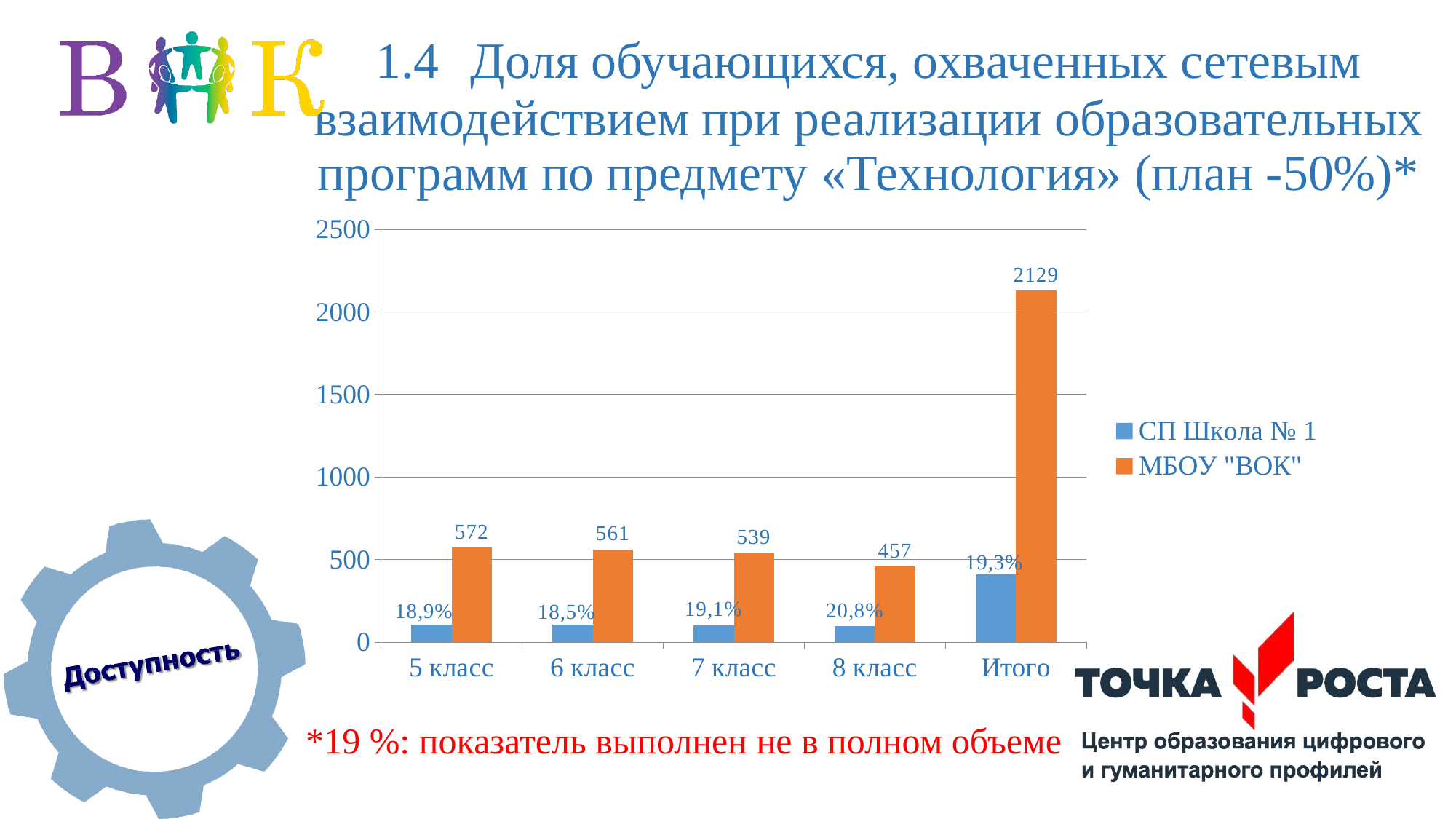
What data label is shown for СП Школа № 1 in Итого? 19,3% What is the value for МБОУ "ВОК" in Итого? 2129 Is the value of the СП Школа № 1 bar for Итого greater or less than 500? less How many categories are shown on the x axis? 5 What data label is shown for СП Школа № 1 in 8 класс? 20,8% What is the value for МБОУ "ВОК" in 5 класс? 572 Do the МБОУ "ВОК" values rise or fall from 5 класс to 8 класс? fall Which category has the highest value for МБОУ "ВОК"? Итого Which is larger for МБОУ "ВОК": 6 класс or 7 класс? 6 класс Which category has the lowest value for МБОУ "ВОК"? 8 класс What is the difference between the МБОУ "ВОК" values for 5 класс and 8 класс? 115 How many series does the legend list? 2